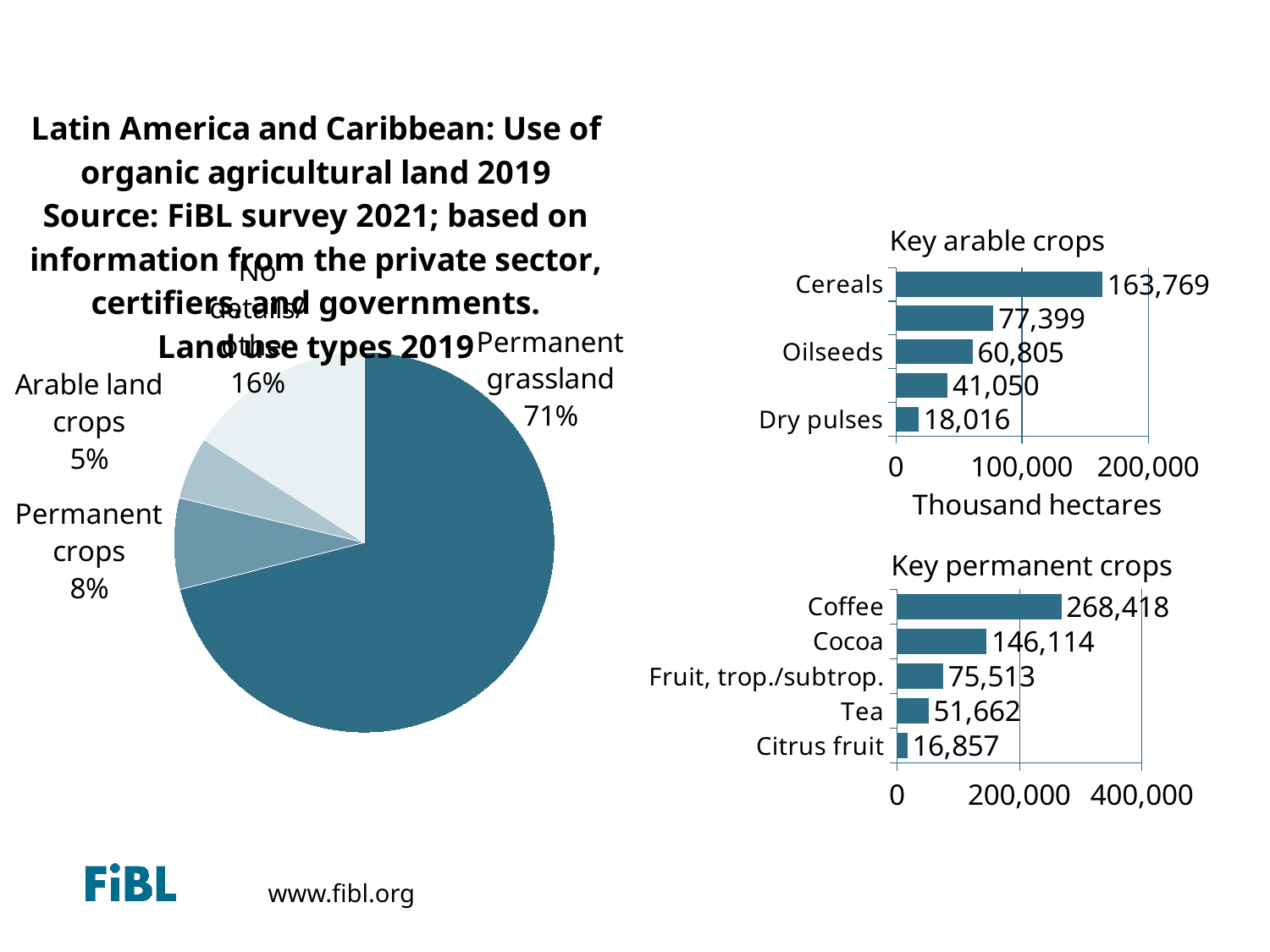
In the Key arable crops chart, what is the value for Cereals? 163,769 In the Land use types 2019 pie chart, what share does Permanent grassland have? 71% In the Key arable crops chart, which crop has the lowest value? Dry pulses In the Key permanent crops chart, what is the value for Cocoa? 146,114 In the Key permanent crops chart, which is larger, Tea or Citrus fruit? Tea In the Key arable crops chart, what is the difference between Cereals and Dry pulses? 145,753 In the Key arable crops chart, what unit is shown on the x axis? Thousand hectares In the Key permanent crops chart, how many crops are shown? 5 In the Key arable crops chart, what is the value for Oilseeds? 60,805 In the Key permanent crops chart, which crop has the highest value? Coffee In the Key permanent crops chart, what is the difference between Coffee and Cocoa? 122,304 What kind of chart is the Key permanent crops chart? Bar chart